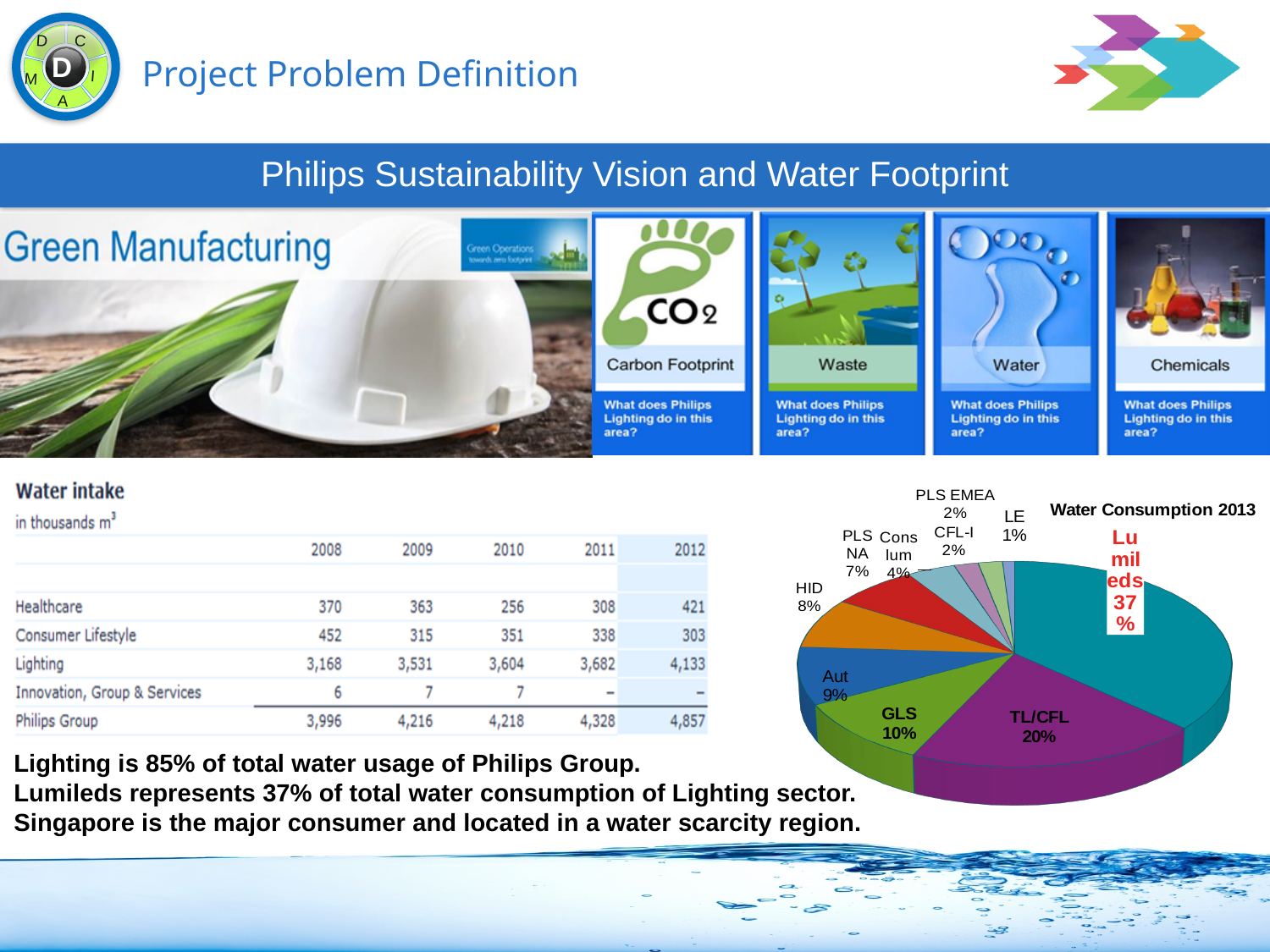
In the Water Consumption 2013 pie chart, what share does GLS have? 10% In the Water Consumption 2013 pie chart, what share does HID have? 8% In the Water Consumption 2013 pie chart, what share does PLS NA have? 7% What is the title of the pie chart on the slide? Water Consumption 2013 In the Water Consumption 2013 pie chart, what is the difference in percentage points between Lumileds and TL/CFL? 17 What kind of chart is the Water Consumption 2013 chart? pie chart In the Water Consumption 2013 pie chart, which is larger, Aut or GLS? GLS In the Water Consumption 2013 pie chart, how many slices are there? 10 In the Water Consumption 2013 pie chart, which slice is the largest? Lumileds In the Water Consumption 2013 pie chart, which slice is the smallest? LE